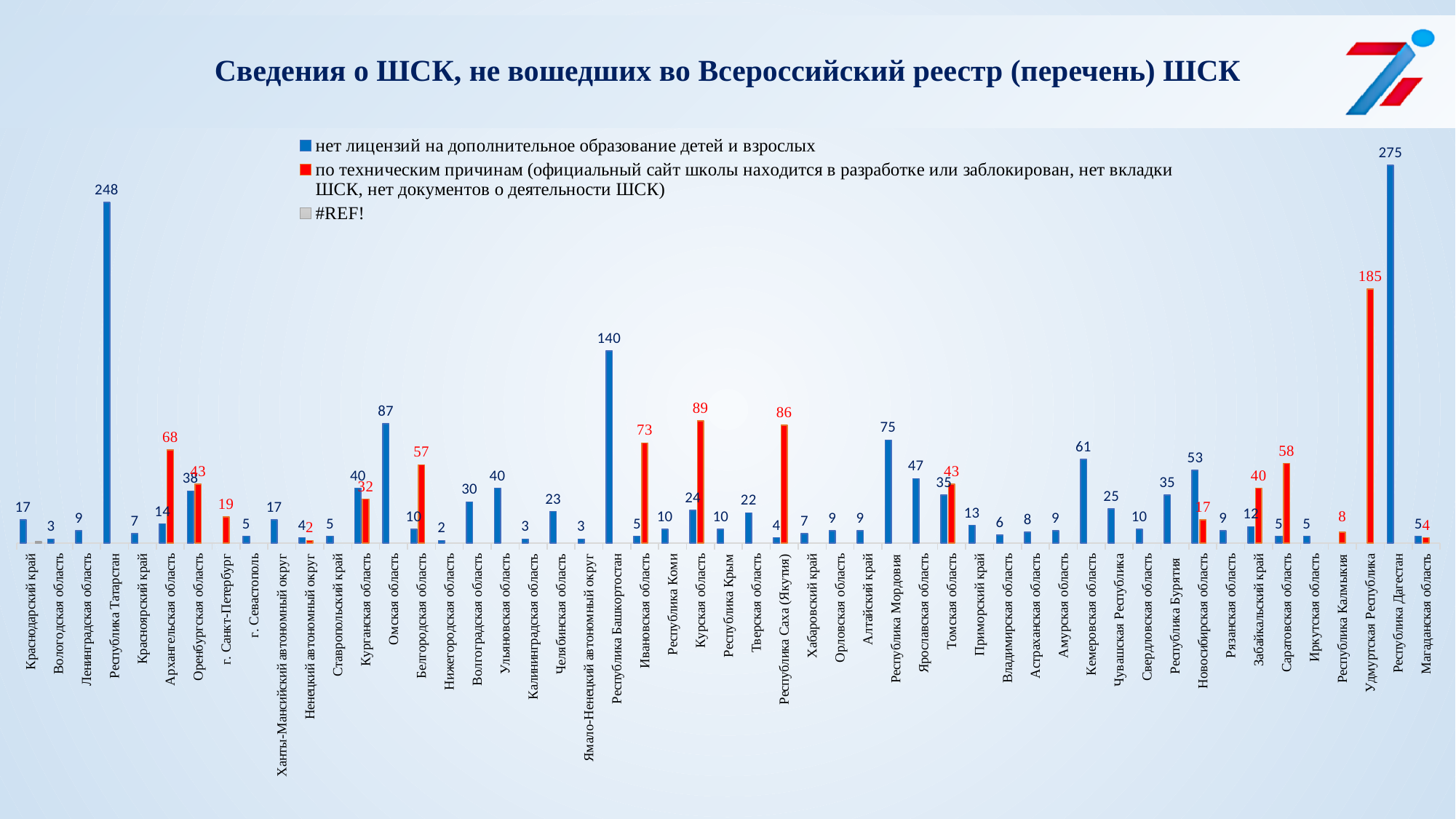
Which is larger for Новосибирская область: the 'нет лицензий' value or the 'по техническим причинам' value? нет лицензий (53) What type of chart is shown on the slide? bar chart What is the value for Курская область in the series 'по техническим причинам'? 89 How many series does the legend list? 3 Which region has the highest value in the series 'нет лицензий на дополнительное образование детей и взрослых'? Республика Дагестан What is the value for Республика Башкортостан in the series 'нет лицензий на дополнительное образование детей и взрослых'? 140 What is the value for Республика Татарстан in the series 'нет лицензий на дополнительное образование детей и взрослых'? 248 What is the difference between the 'по техническим причинам' value and the 'нет лицензий' value for Архангельская область? 54 Which region has the highest value in the series 'по техническим причинам'? Удмуртская Республика What is the value for Удмуртская Республика in the series 'по техническим причинам'? 185 What is the difference between the 'нет лицензий' values for Республика Дагестан and Республика Татарстан? 27 What is the title of the chart? Сведения о ШСК, не вошедших во Всероссийский реестр (перечень) ШСК